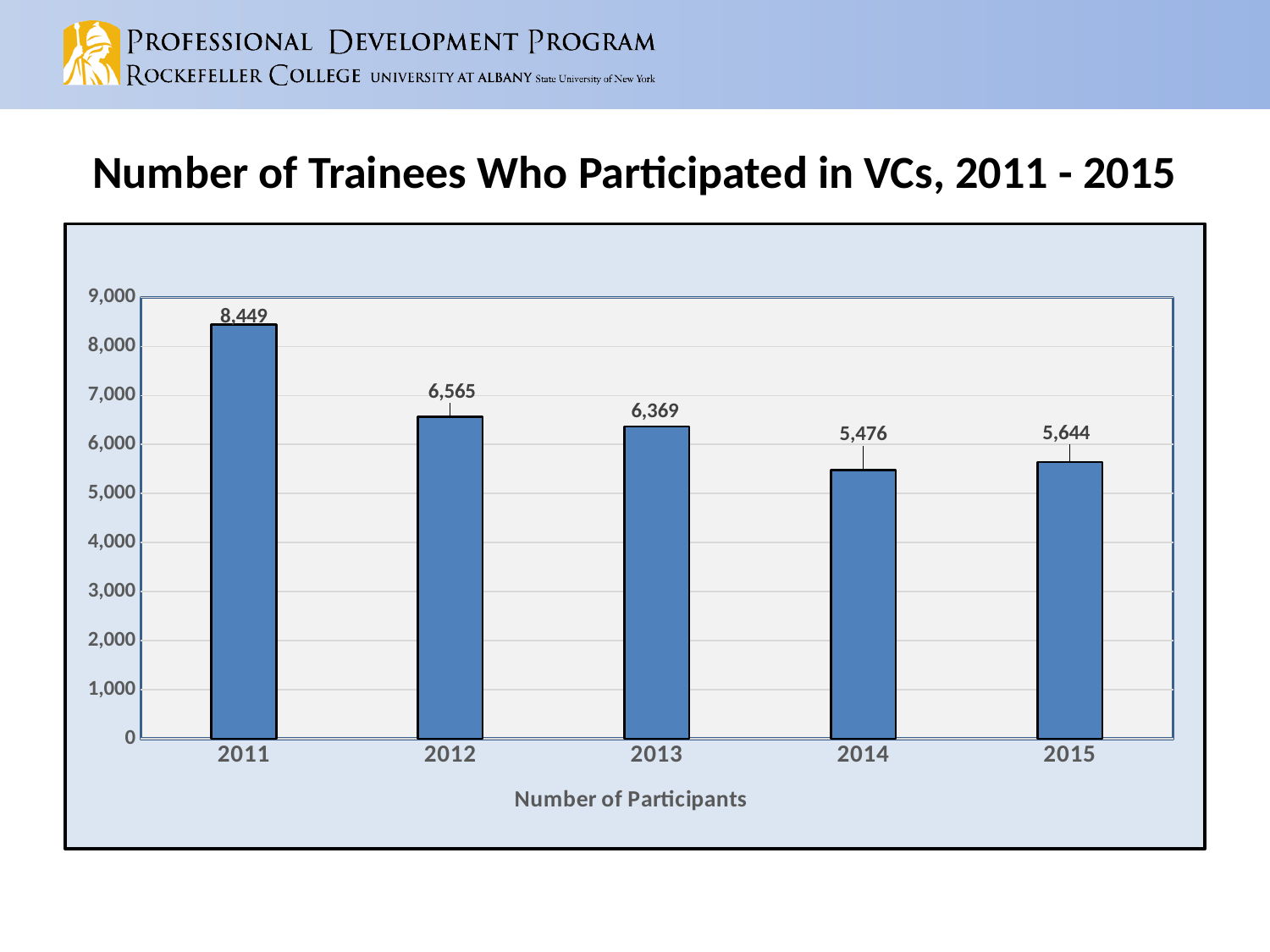
What kind of chart is shown on the slide? bar chart How many years are shown on the chart? 5 Which year has the lowest number of participants? 2014 What is the title of the chart? Number of Trainees Who Participated in VCs, 2011 - 2015 What is the number of participants for 2011? 8,449 Which year has the highest number of participants? 2011 What is the number of participants for 2014? 5,476 What is the number of participants for 2015? 5,644 What is the difference in participants between 2015 and 2014? 168 What is the difference in participants between 2011 and 2012? 1,884 Which year had more participants, 2012 or 2013? 2012 Is the value for 2013 greater or less than 7,000? less